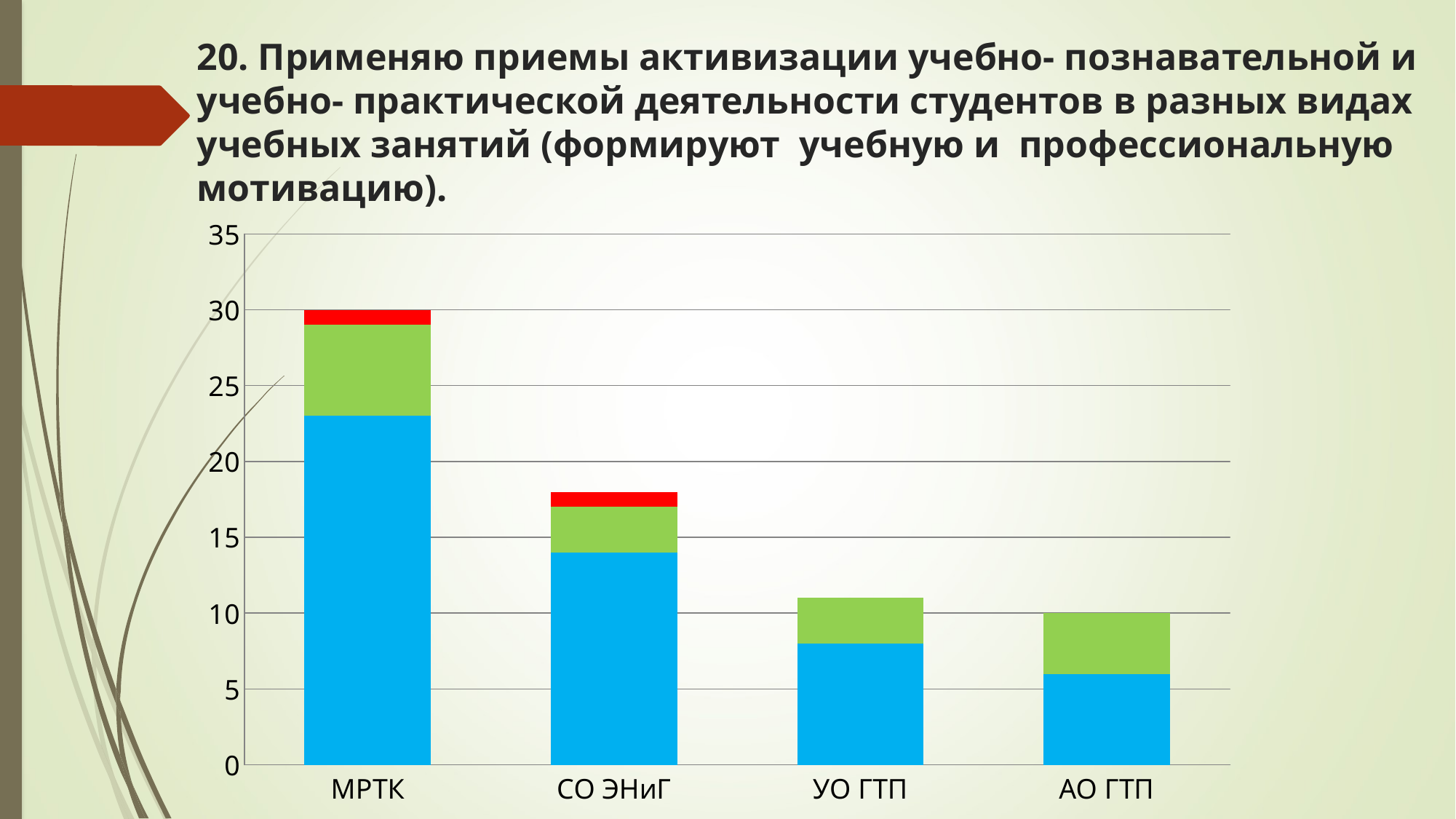
How many categories are shown on the x axis of the chart? 4 Which category has the shortest stacked bar? АО ГТП Which stacked bar is taller, МРТК or СО ЭНиГ? МРТК Is the total value for УО ГТП greater or less than 10? greater Which category has the tallest stacked bar? МРТК What is the total height of the stacked bar for АО ГТП? 10 How many coloured segments make up the МРТК bar? 3 What is the total height of the stacked bar for МРТК? 30 Is the blue segment of the МРТК bar greater or less than 20? greater Is the total value for СО ЭНиГ greater or less than 20? less What kind of chart is shown on the slide? bar chart Do the total bar heights rise or fall from left to right along the x axis? fall